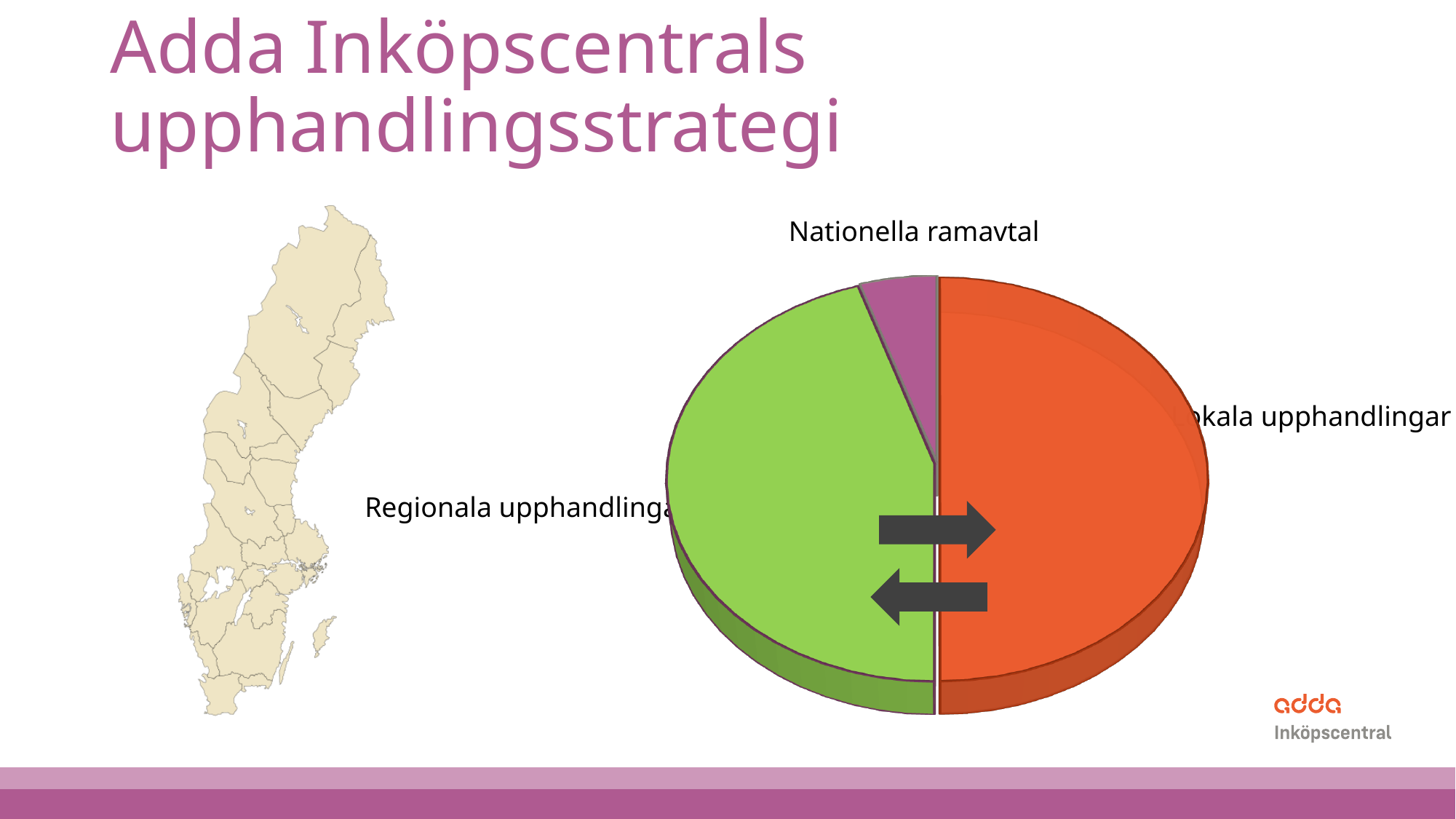
Which slice of the pie chart is the smallest? Nationella ramavtal What colour is the Regionala upphandlingar slice of the pie chart? green Is the Regionala upphandlingar slice larger or smaller than the Nationella ramavtal slice? larger How many slices does the pie chart have? 3 What colour is the Nationella ramavtal slice of the pie chart? purple What kind of chart is shown on the slide? pie chart